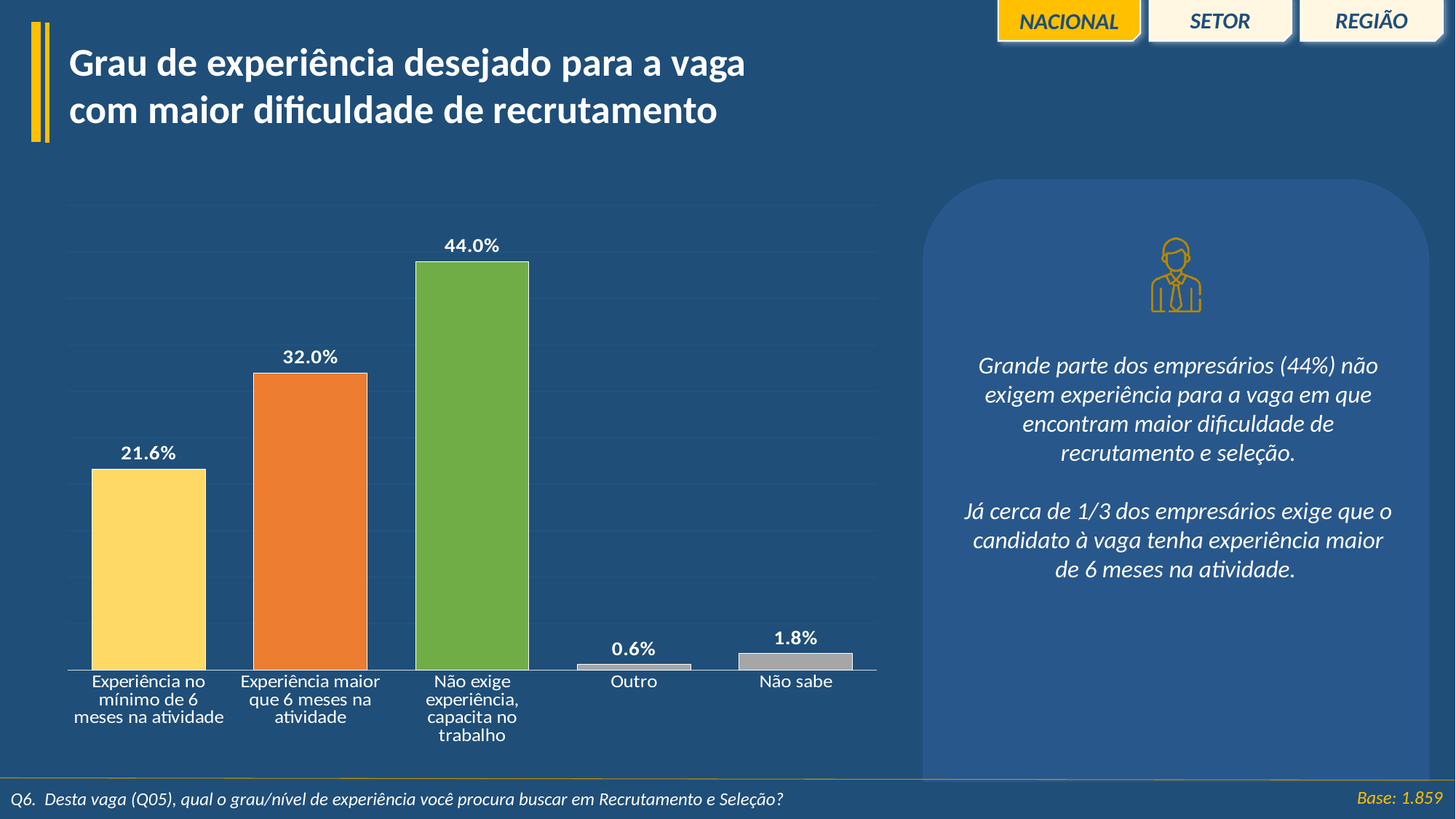
What is the difference between the values for "Não exige experiência, capacita no trabalho" and "Experiência maior que 6 meses na atividade"? 12.0% Which is larger: the value for "Experiência no mínimo de 6 meses na atividade" or the value for "Experiência maior que 6 meses na atividade"? Experiência maior que 6 meses na atividade How many categories are shown in the chart? 5 What kind of chart is shown on the slide? Bar chart What is the value for "Não sabe"? 1.8% What is the value for "Experiência no mínimo de 6 meses na atividade"? 21.6% Which category has the highest value? Não exige experiência, capacita no trabalho What is the value for "Experiência maior que 6 meses na atividade"? 32.0% What is the value for "Outro"? 0.6% What is the value for "Não exige experiência, capacita no trabalho"? 44.0% What is the title of the slide containing the chart? Grau de experiência desejado para a vaga com maior dificuldade de recrutamento Which category has the lowest value? Outro